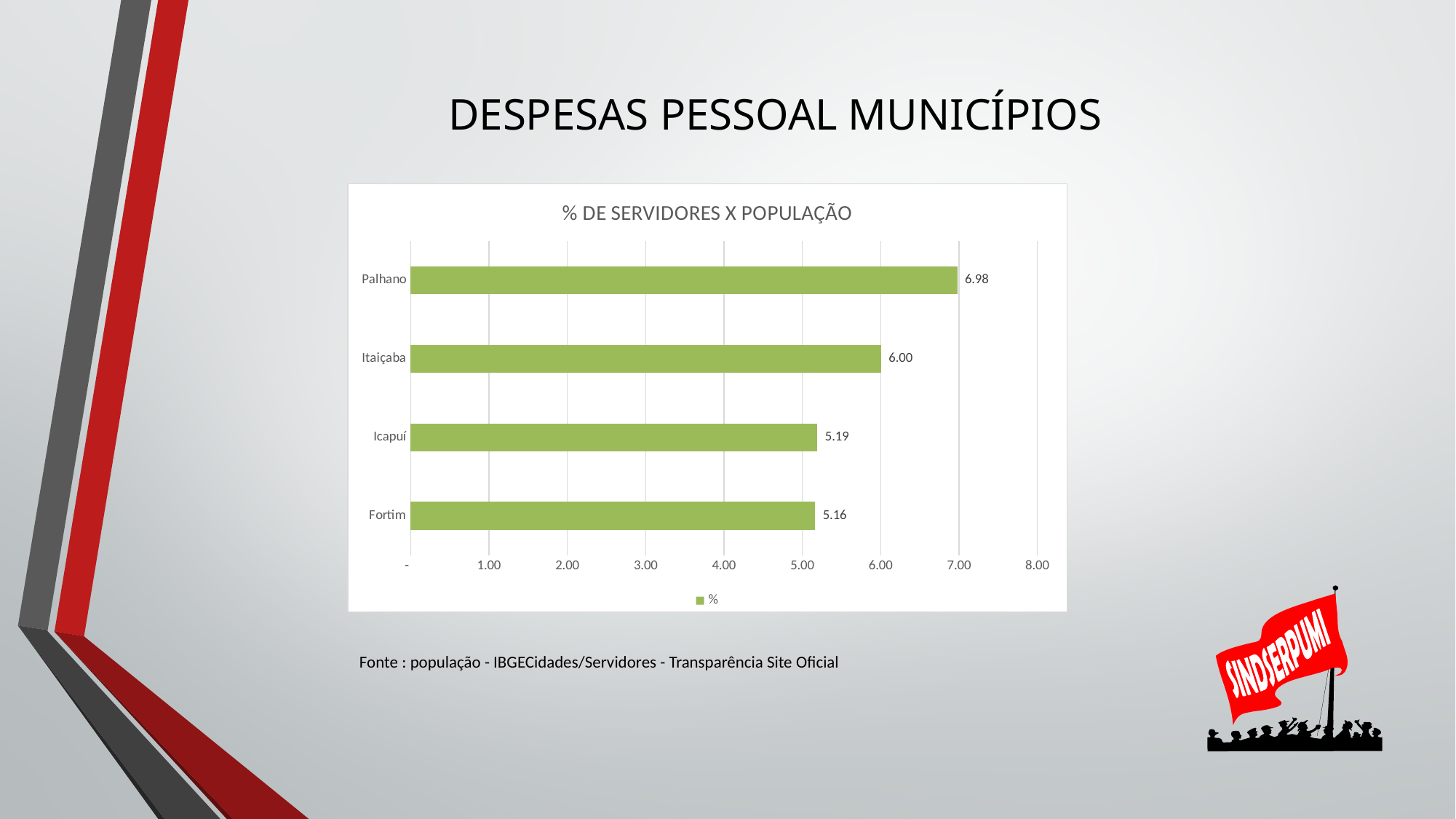
What is the value for Itaiçaba? 6.00 What is the difference between the values for Palhano and Itaiçaba? 0.98 What is the title of the chart? % DE SERVIDORES X POPULAÇÃO What is the value for Fortim? 5.16 What is the difference between the values for Icapuí and Fortim? 0.03 How many municipalities are shown in the chart? 4 What kind of chart is shown on the slide? Bar chart Which municipality has the lowest value? Fortim What is the value for Palhano? 6.98 What is the value for Icapuí? 5.19 Which is larger, the value for Itaiçaba or the value for Icapuí? Itaiçaba Which municipality has the highest value? Palhano